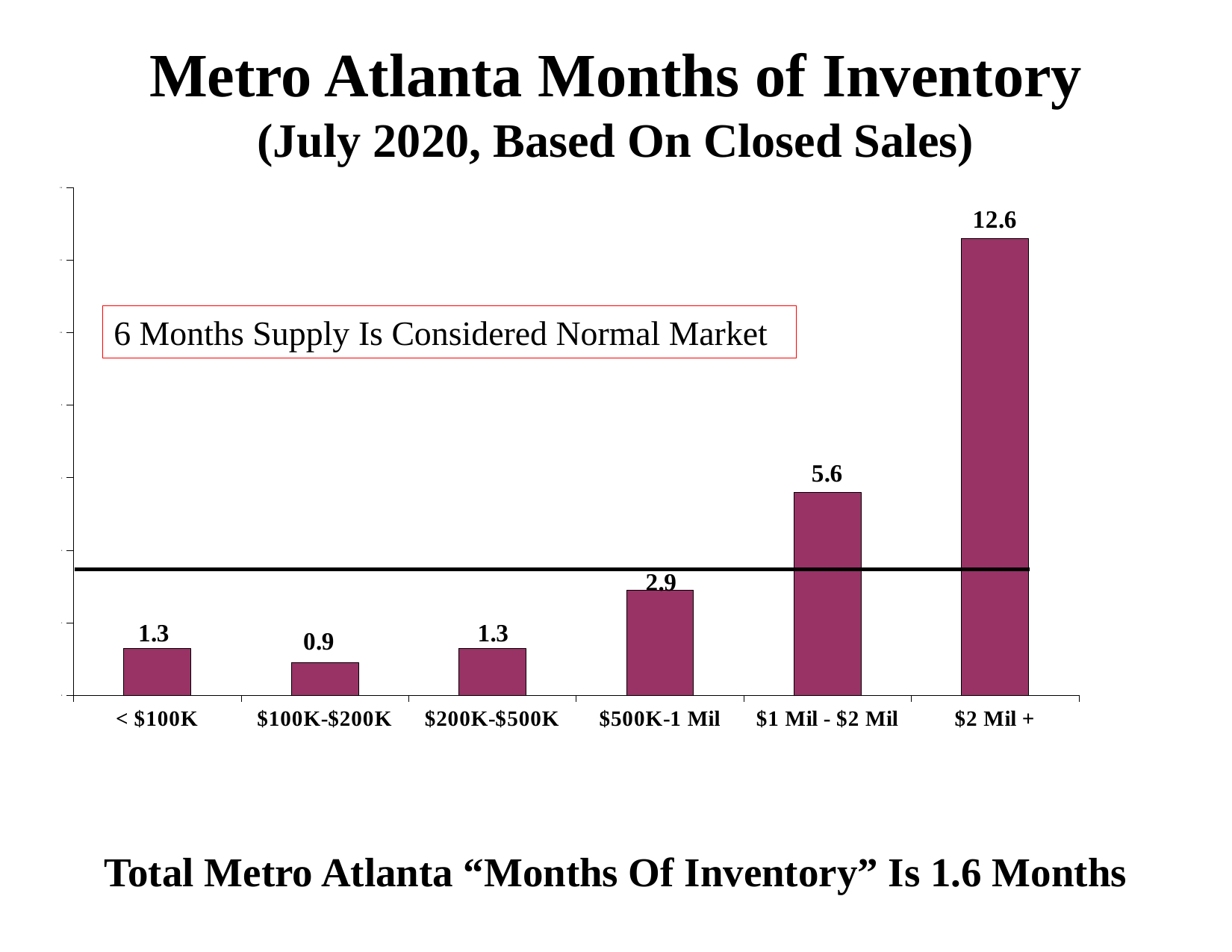
According to the text box on the chart, how many months of supply is considered a normal market? 6 Months Which price range has the lowest months of inventory? $100K-$200K What is the months of inventory value for the $2 Mil + price range? 12.6 What is the months of inventory value for the $1 Mil - $2 Mil price range? 5.6 What is the difference in months of inventory between the $500K-1 Mil and $200K-$500K price ranges? 1.6 What is the difference in months of inventory between the $2 Mil + and $1 Mil - $2 Mil price ranges? 7.0 What is the months of inventory value for the $100K-$200K price range? 0.9 What type of chart is shown on the slide? Bar chart Which price range has the highest months of inventory? $2 Mil + How many price range categories are shown on the chart? 6 What is the months of inventory value for the $500K-1 Mil price range? 2.9 Which has a larger months of inventory value, $1 Mil - $2 Mil or $500K-1 Mil? $1 Mil - $2 Mil